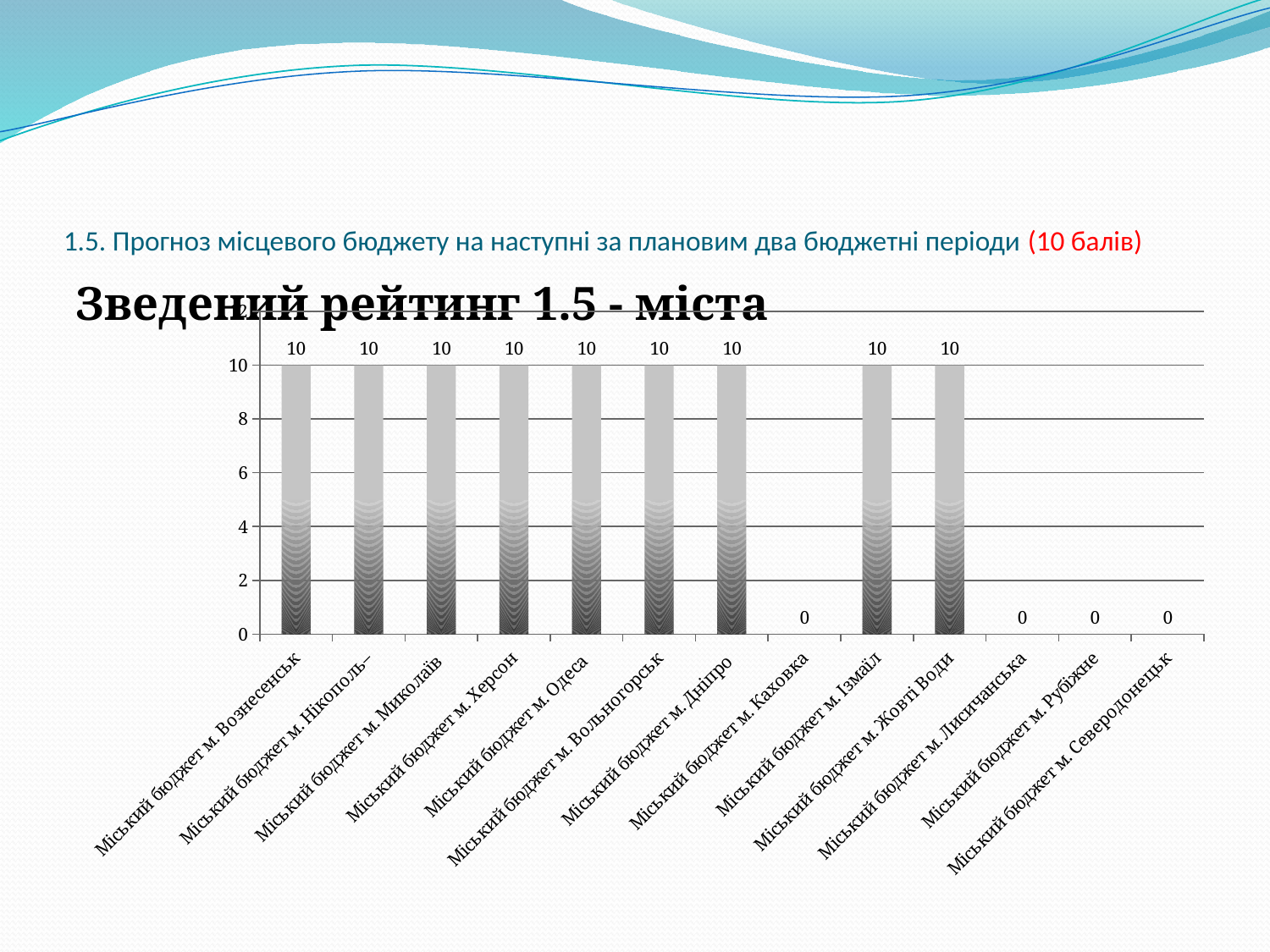
What kind of chart is shown on the slide? bar chart How many categories have a value of 10? 9 Which is larger, the value for Міський бюджет м. Жовті Води or the value for Міський бюджет м. Лисичанська? Міський бюджет м. Жовті Води What is the value for Міський бюджет м. Рубіжне? 0 How many categories are shown on the x axis of the chart? 13 What is the difference between the values for Міський бюджет м. Дніпро and Міський бюджет м. Каховка? 10 What is the value for Міський бюджет м. Одеса? 10 What is the title of the chart? Зведений рейтинг 1.5 - міста What is the value for Міський бюджет м. Каховка? 0 Is the value for Міський бюджет м. Херсон greater or less than 8? greater What is the value for Міський бюджет м. Ізмаїл? 10 How many categories have a value of 0? 4